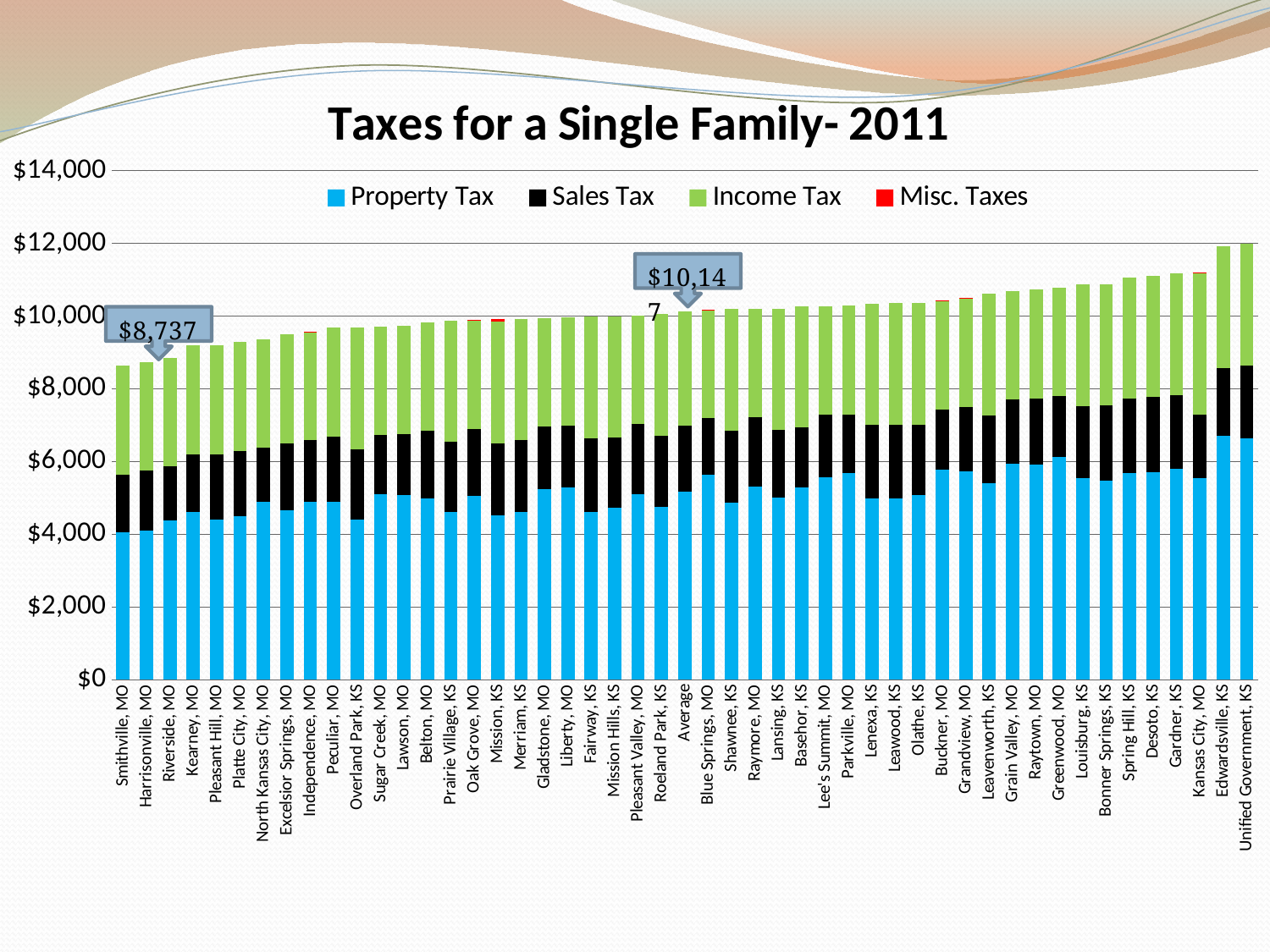
Is the total for Unified Government, KS greater or less than $10,000? greater What type of chart is shown on the slide? Stacked bar chart How many series does the legend list? 4 Is the Property Tax value for Edwardsville, KS greater or less than $6,000? greater What is the difference between the labelled Average total and the labelled Smithville, MO total? $1,410 Which has a larger total: Unified Government, KS or Smithville, MO? Unified Government, KS What is the total tax value labelled for Smithville, MO? $8,737 What is the total tax value labelled for the Average bar? $10,147 Is the total for Smithville, MO greater or less than $10,000? less Which category has the lowest total taxes? Smithville, MO Do the total bar heights generally rise or fall from left to right along the x axis? Rise What colour represents Income Tax in the legend? Green